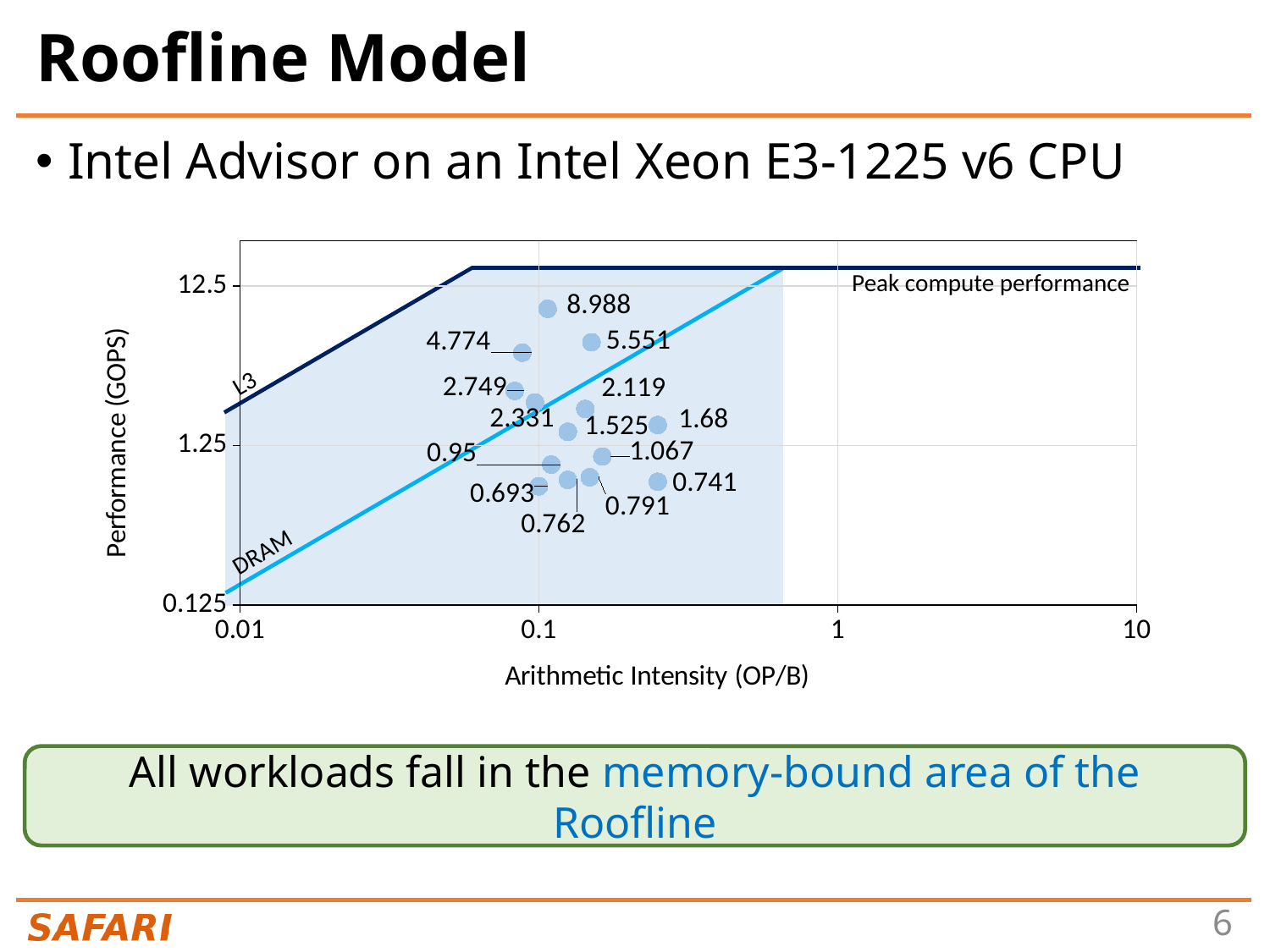
What is the difference between the points labeled 2.749 and 2.119? 0.63 Is the performance of the point labeled 0.741 greater or less than 1.25 GOPS? less Which labeled point has the larger value, the one labeled 5.551 or the one labeled 4.774? 5.551 What is the title of the y-axis of the chart? Performance (GOPS) What kind of chart is shown on the slide? scatter chart Is the performance of the point labeled 8.988 greater or less than 12.5 GOPS? less What is the highest labeled performance value among the plotted workload points? 8.988 Which labeled point has the larger value, the one labeled 1.68 or the one labeled 1.525? 1.68 What is the lowest labeled performance value among the plotted workload points? 0.693 How many labeled workload data points are plotted on the chart? 14 What is the difference between the highest labeled point (8.988) and the lowest labeled point (0.693)? 8.295 What is the title of the x-axis of the chart? Arithmetic Intensity (OP/B)